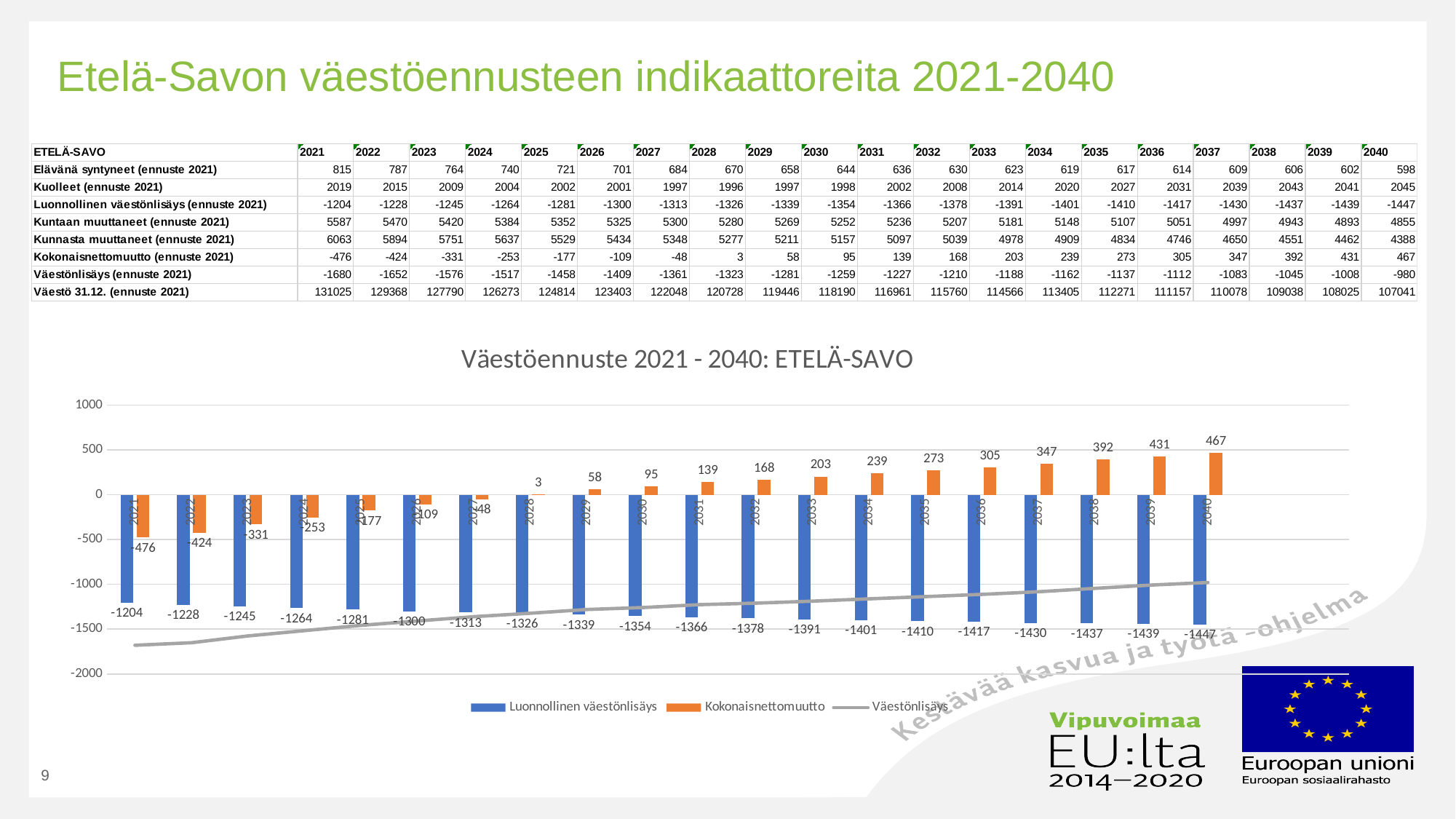
What is the value of Luonnollinen väestönlisäys for 2040 in the chart? -1447 Is the Kokonaisnettomuutto value for 2035 larger or smaller than the value for 2030? larger What is the difference between the Kokonaisnettomuutto values for 2040 and 2021 in the chart? 943 Does the Kokonaisnettomuutto series rise or fall from 2021 to 2040 in the chart? rise How many series does the chart legend list? 3 Which year has the highest Kokonaisnettomuutto value in the chart? 2040 What is the value of Kokonaisnettomuutto for 2021 in the chart? -476 What is the title of the chart? Väestöennuste 2021 - 2040: ETELÄ-SAVO Which year has the lowest Luonnollinen väestönlisäys value in the chart? 2040 What is the value of Kokonaisnettomuutto for 2028 in the chart? 3 Which series in the chart is drawn as a line rather than bars? Väestönlisäys How many years are shown on the x axis of the chart? 20